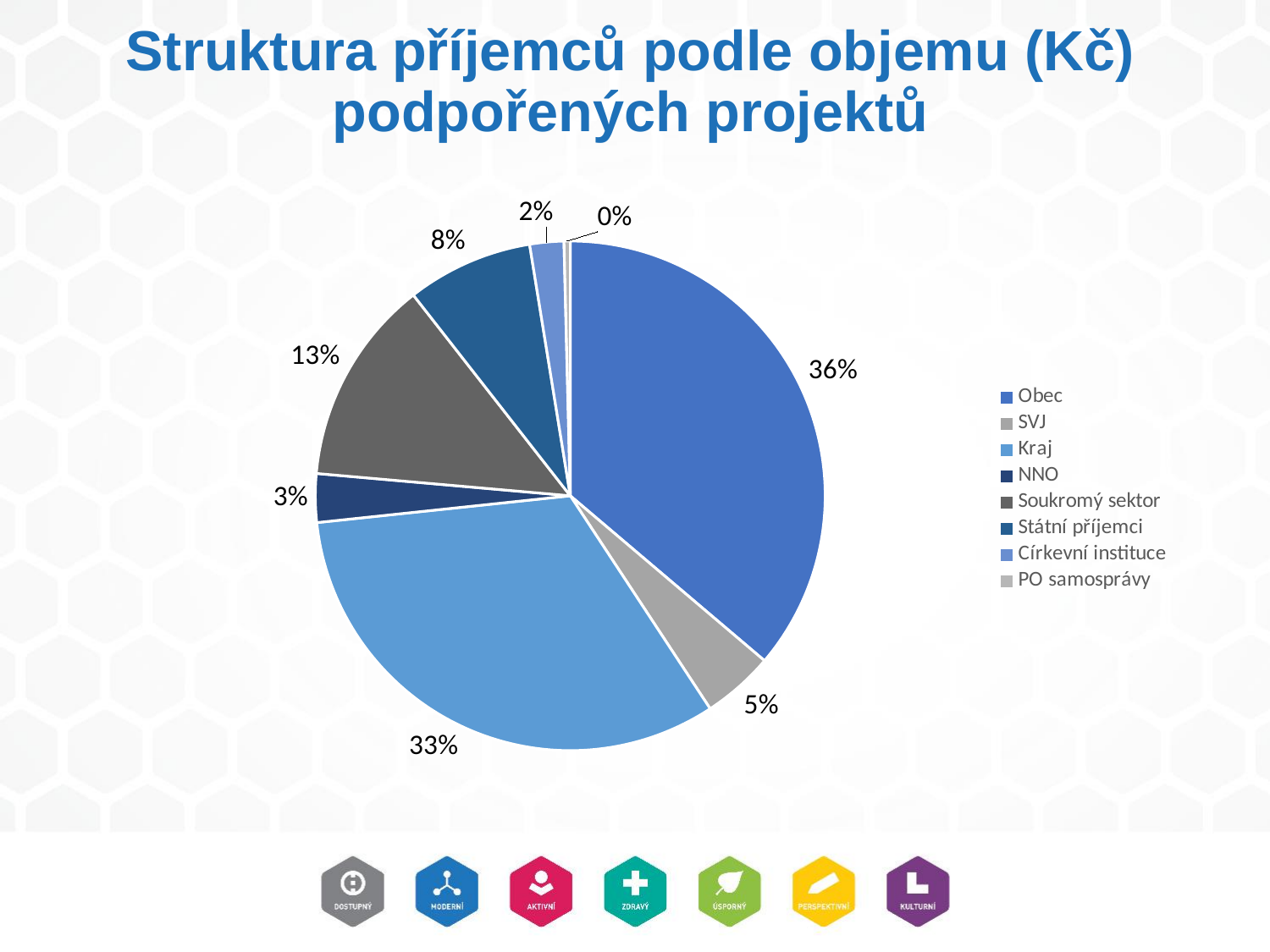
What share of the pie does Státní příjemci have? 8% What share of the pie does Kraj have? 33% Which category has the largest share of the pie? Obec What share of the pie does Soukromý sektor have? 13% What is the title of the chart? Struktura příjemců podle objemu (Kč) podpořených projektů Which category has the smallest share of the pie? PO samosprávy How many categories does the legend list? 8 Which has a larger share, Soukromý sektor or Státní příjemci? Soukromý sektor What kind of chart is shown on the slide? pie chart What is the difference in percentage points between the shares of Obec and Kraj? 3